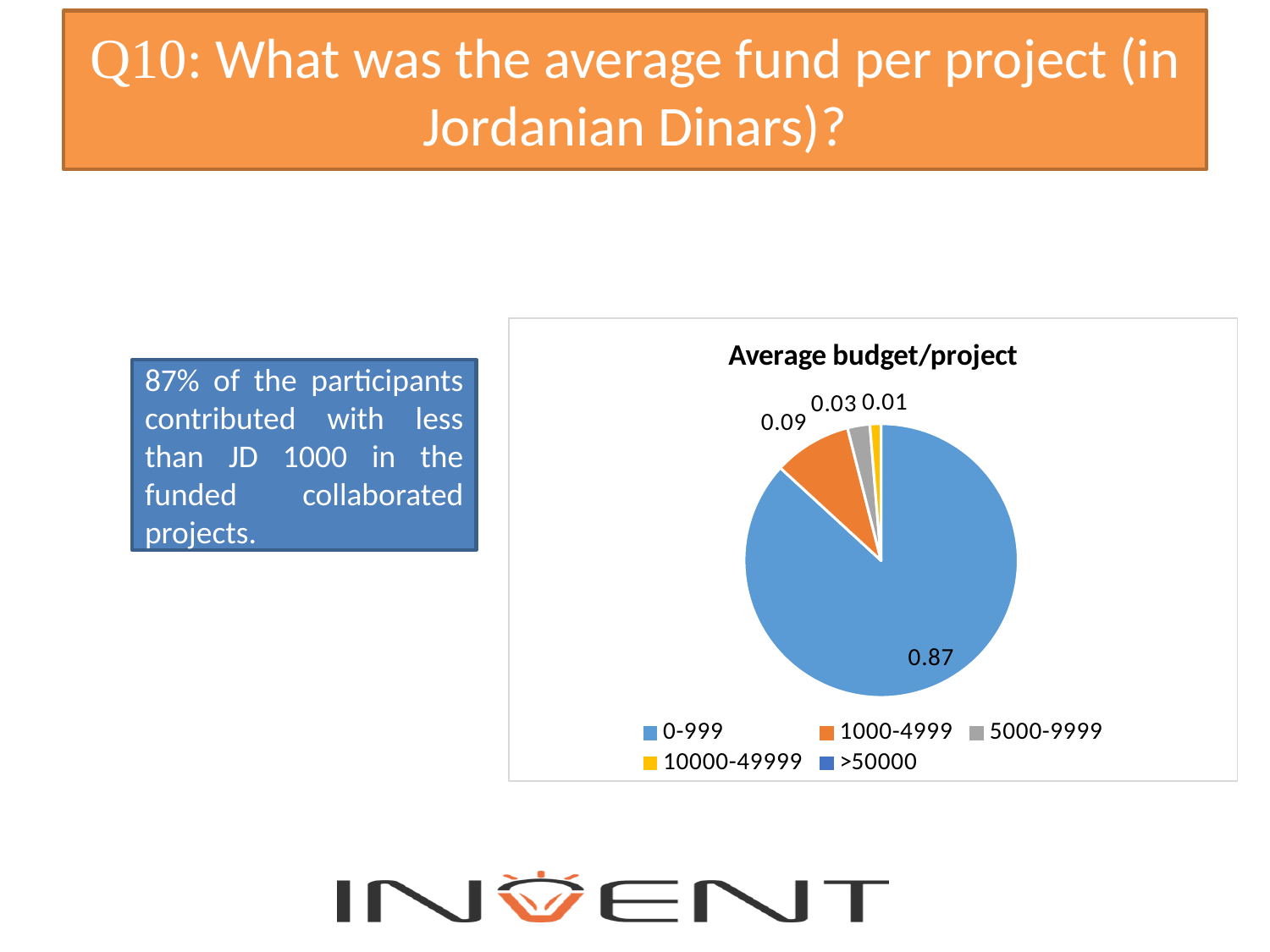
What value is shown for the 1000-4999 category? 0.09 What is the title of the chart? Average budget/project What colour is the 0-999 slice? blue What value is shown for the 0-999 category? 0.87 Which category has the largest share of the pie? 0-999 What value is shown for the 5000-9999 category? 0.03 Which is larger, the value for 1000-4999 or the value for 5000-9999? 1000-4999 What kind of chart is shown on the slide? pie chart What is the difference between the values for 1000-4999 and 5000-9999? 0.06 What value is shown for the 10000-49999 category? 0.01 What is the difference between the values for 0-999 and 1000-4999? 0.78 How many categories does the legend list? 5